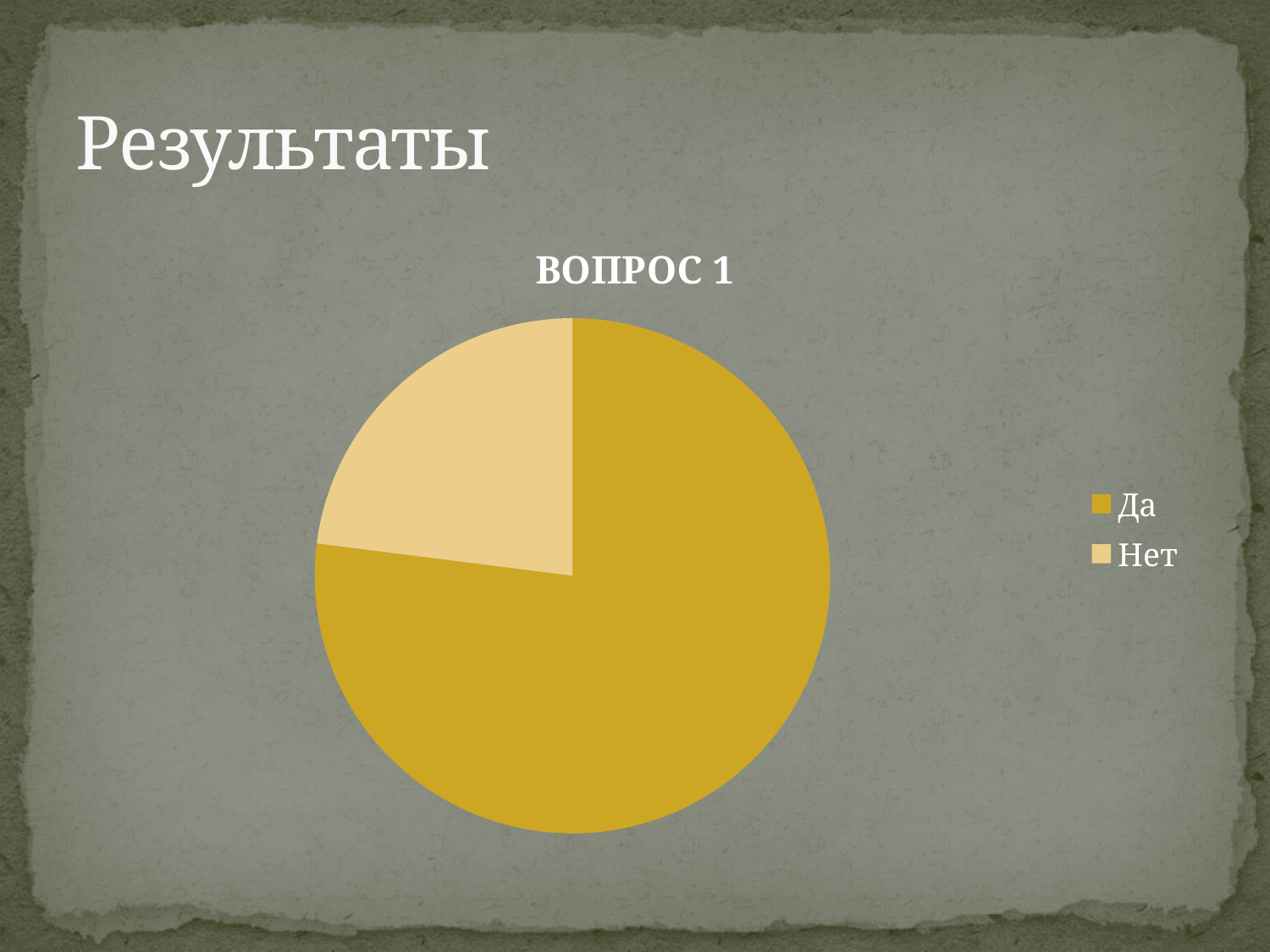
What kind of chart is shown on the slide? pie chart Which slice is larger, Да or Нет? Да How many entries does the legend list? 2 How many slices does the pie chart have? 2 Does the Да slice take up more or less than half of the pie? more What is the title of the chart? ВОПРОС 1 Which legend entry is shown in the lighter colour? Нет Which category has the largest slice of the pie? Да Which category has the smallest slice of the pie? Нет